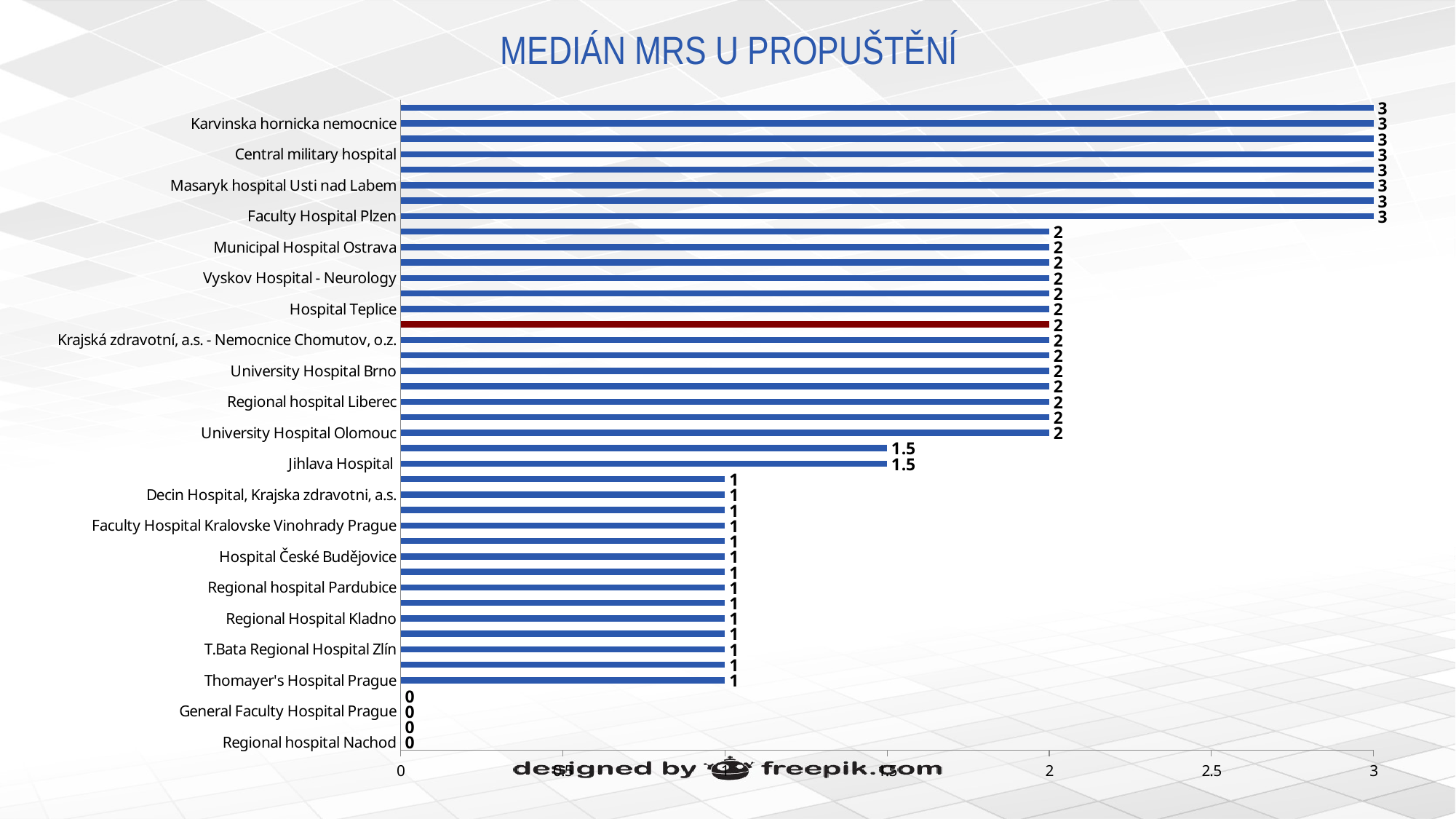
What is the title of the chart? MEDIÁN MRS U PROPUŠTĚNÍ What value is labelled on the single red bar in the chart? 2 Is the value for Hospital Teplice greater or less than 1.5? greater What kind of chart is shown on the slide? bar chart What is the value for Regional hospital Nachod? 0 Which has the larger value, Faculty Hospital Plzen or Municipal Hospital Ostrava? Faculty Hospital Plzen What is the value for Karvinska hornicka nemocnice? 3 What is the value for Jihlava Hospital? 1.5 What is the value for University Hospital Brno? 2 What is the largest value shown by any bar in the chart? 3 What is the difference between the values for Jihlava Hospital and Regional Hospital Kladno? 0.5 What is the difference between the values for Central military hospital and Thomayer's Hospital Prague? 2